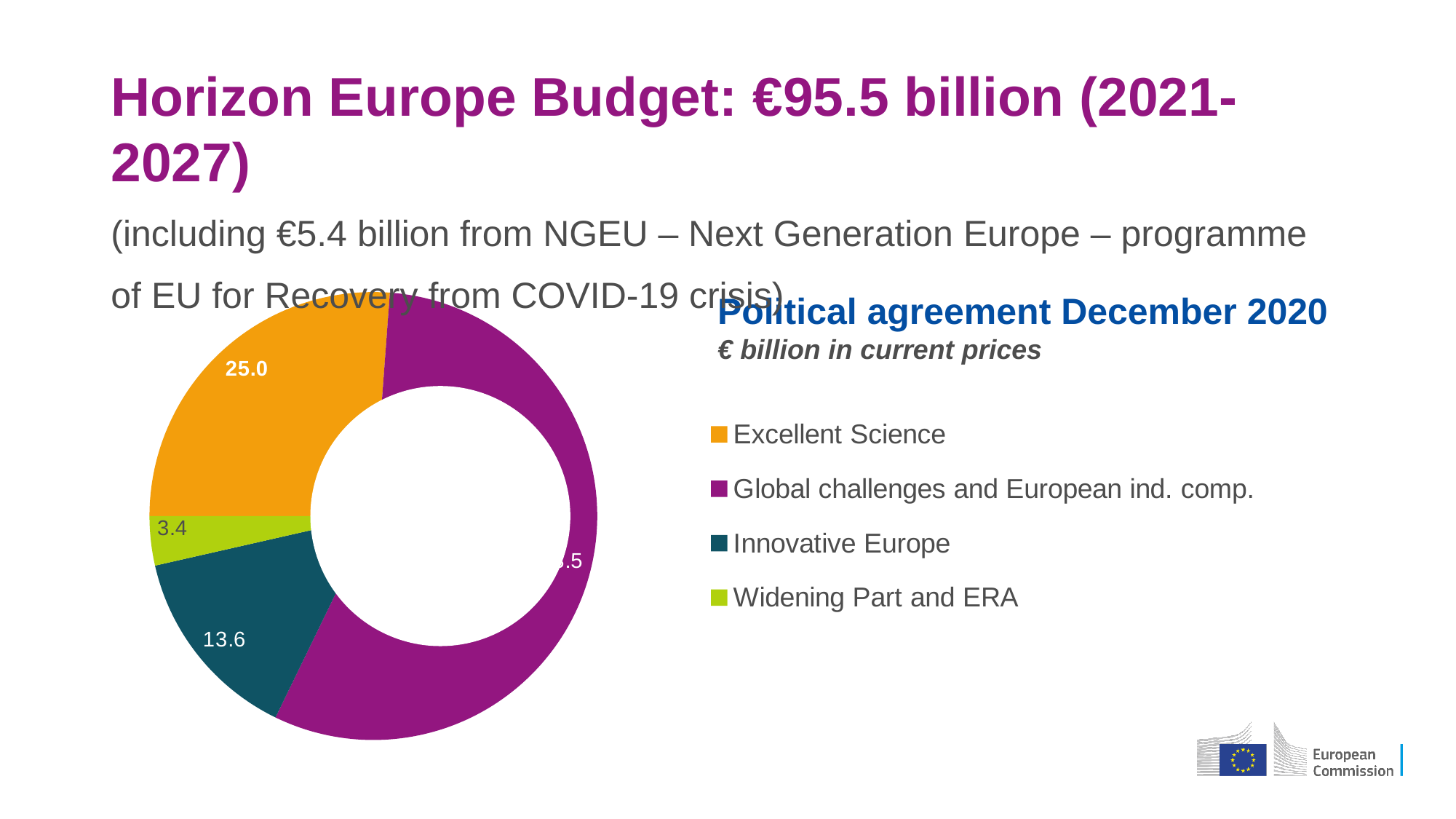
What colour represents Excellent Science in the chart? Orange What is the value shown for Widening Part and ERA in the chart? 3.4 Which is larger, the value for Excellent Science or the value for Innovative Europe? Excellent Science What kind of chart is shown on the slide? Pie (doughnut) chart What is the value shown for Innovative Europe in the chart? 13.6 Which category has the largest slice in the chart? Global challenges and European ind. comp. What is the value shown for Excellent Science in the chart? 25.0 How many entries does the chart legend list? 4 How many categories are shown in the chart? 4 What is the difference between the values for Innovative Europe and Widening Part and ERA? 10.2 Which category has the smallest slice in the chart? Widening Part and ERA What is the difference between the values for Excellent Science and Innovative Europe? 11.4